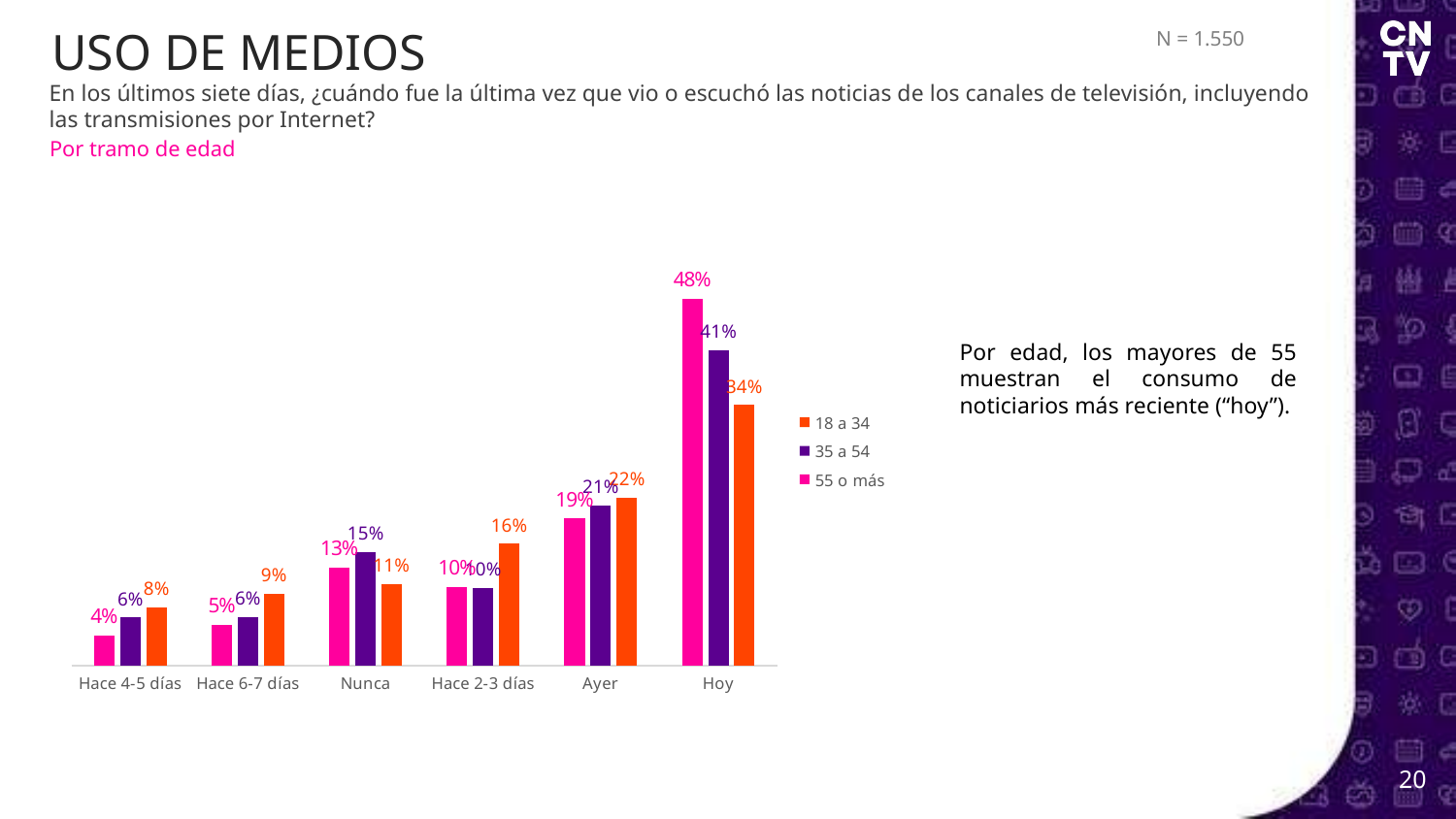
In the Nunca category, which is larger: the 35 a 54 value or the 18 a 34 value? 35 a 54 What is the value for the 18 a 34 series in the Hace 2-3 días category? 16% Which category has the highest value for the 55 o más series? Hoy What is the difference between the 55 o más and 18 a 34 values in the Hoy category? 14% How many series does the legend list? 3 What is the value for the 18 a 34 series in the Hace 6-7 días category? 9% How many categories are shown on the x axis? 6 What is the sample size (N) shown on the slide? 1.550 What is the value for the 55 o más series in the Hoy category? 48% What is the value for the 35 a 54 series in the Nunca category? 15% What kind of chart is shown on the slide? Bar chart Which category has the lowest value for the 55 o más series? Hace 4-5 días